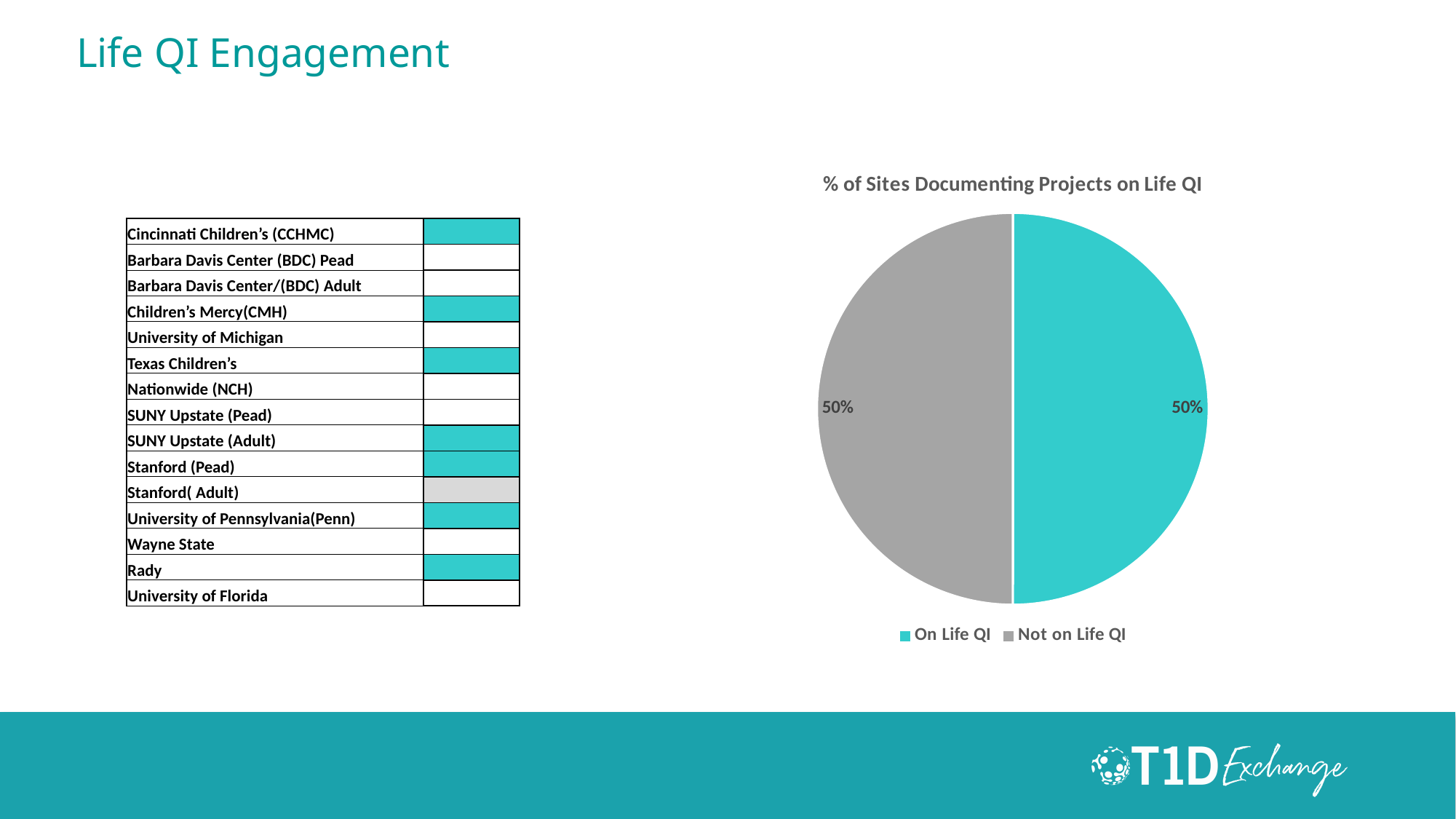
What percentage of sites are shown as Not on Life QI in the pie chart? 50% What share of the pie does the Not on Life QI slice represent? 50% What kind of chart is shown on the slide? pie chart Which colour represents Not on Life QI in the pie chart? grey Is the value for On Life QI in the pie chart greater or less than 40%? greater How many slices does the pie chart have? 2 How many entries does the pie chart's legend list? 2 What is the title of the pie chart? % of Sites Documenting Projects on Life QI What percentage of sites are shown as On Life QI in the pie chart? 50% What is the difference between the On Life QI and Not on Life QI percentages in the pie chart? 0% What share of the pie does the On Life QI slice represent? 50%